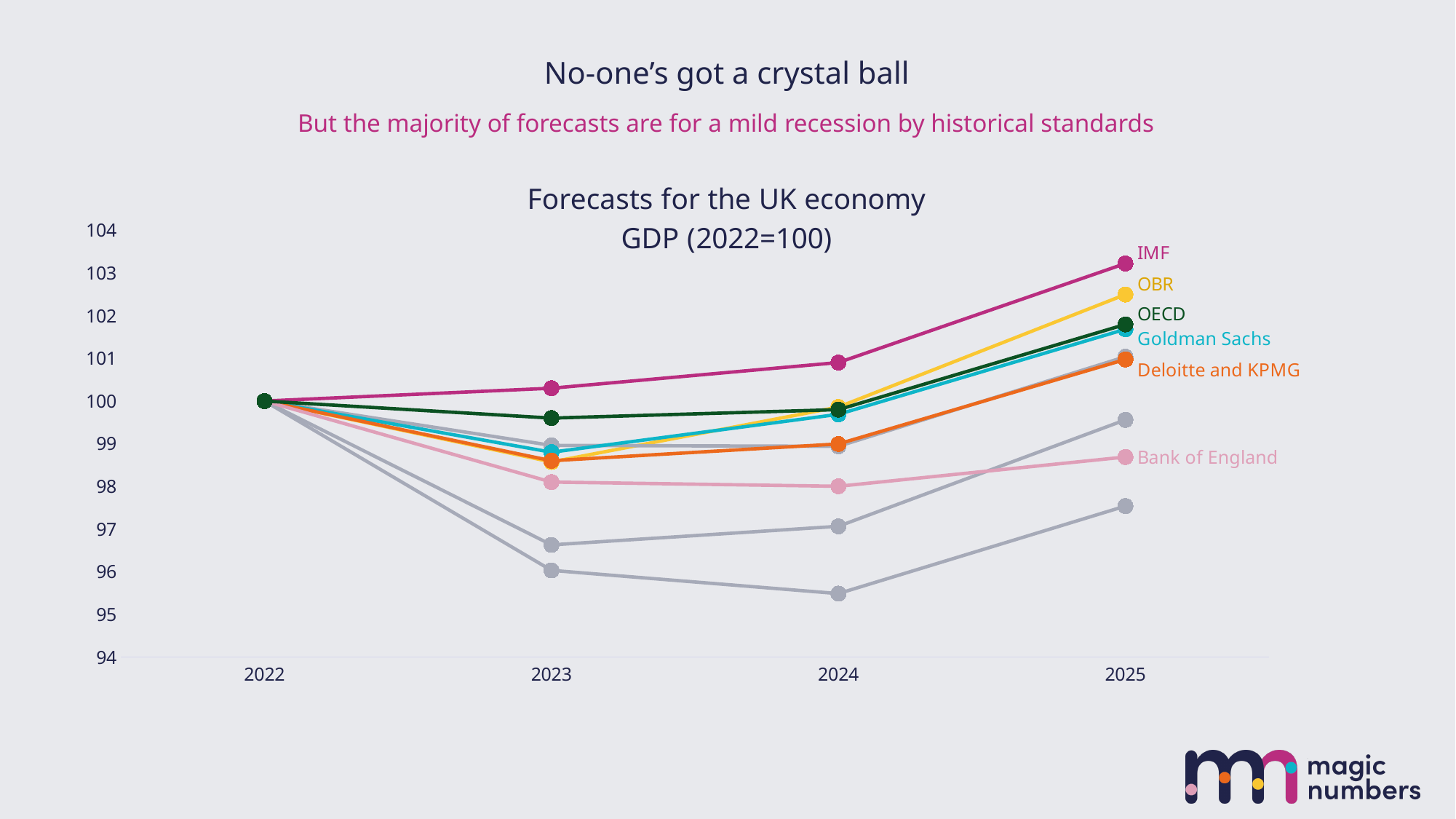
Which is larger in 2025, the Bank of England forecast or the Deloitte and KPMG forecast? Deloitte and KPMG Is the Bank of England value for 2024 greater or less than 99? less How many years are shown on the x axis? 4 What kind of chart is shown on the slide? line chart Which named forecaster has the lowest value in 2025? Bank of England Is the IMF value for 2025 greater or less than 102? greater What is the title of the chart? Forecasts for the UK economy GDP (2022=100) What is the GDP index value for all forecasts in 2022? 100 Which is larger in 2025, the IMF forecast or the OBR forecast? IMF Which named forecaster has the highest value in 2025? IMF How many forecasters are named by label on the chart? 6 Does the IMF line rise or fall from 2022 to 2025? rise